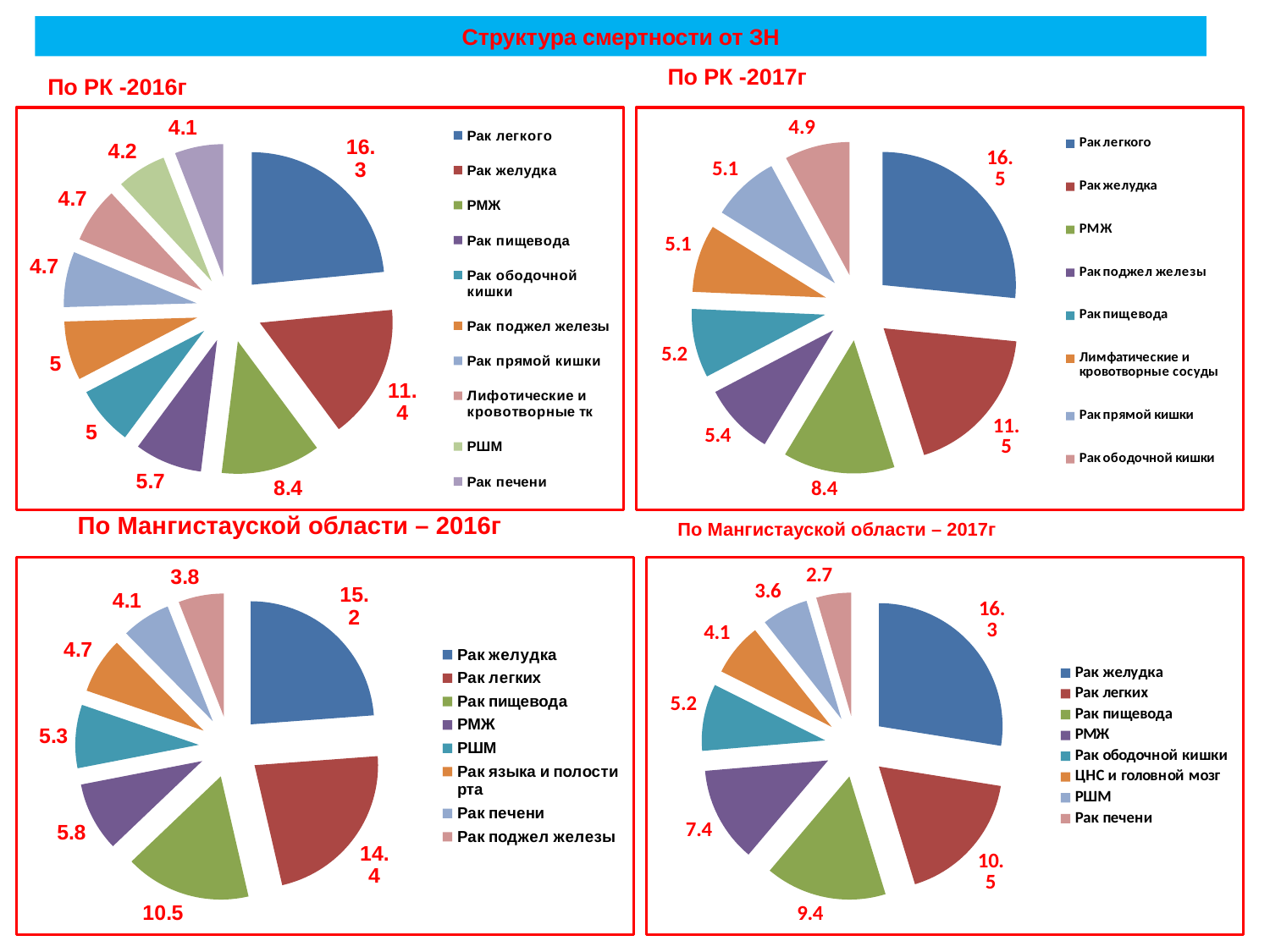
In the 'По Мангистауской области – 2016г' chart, which is larger, Рак желудка or Рак легких? Рак желудка In the 'По Мангистауской области – 2016г' chart, which category has the lowest value? Рак поджел железы In the 'По Мангистауской области – 2017г' chart, what is the difference between Рак желудка and Рак легких? 5.8 In the 'По РК -2016г' chart, what is the value for Рак легкого? 16.3 In the 'По Мангистауской области – 2016г' chart, what is the value for Рак пищевода? 10.5 How many categories does the 'По РК -2016г' pie chart show? 10 In the 'По РК -2016г' chart, which category has the lowest value? Рак печени In the 'По РК -2017г' chart, which category has the highest value? Рак легкого What type of chart is used for 'По Мангистауской области – 2017г'? Pie chart In the 'По РК -2017г' chart, what is the value for Рак желудка? 11.5 In the 'По РК -2017г' chart, what is the difference between Рак легкого and РМЖ? 8.1 In the 'По Мангистауской области – 2017г' chart, what is the value for РМЖ? 7.4